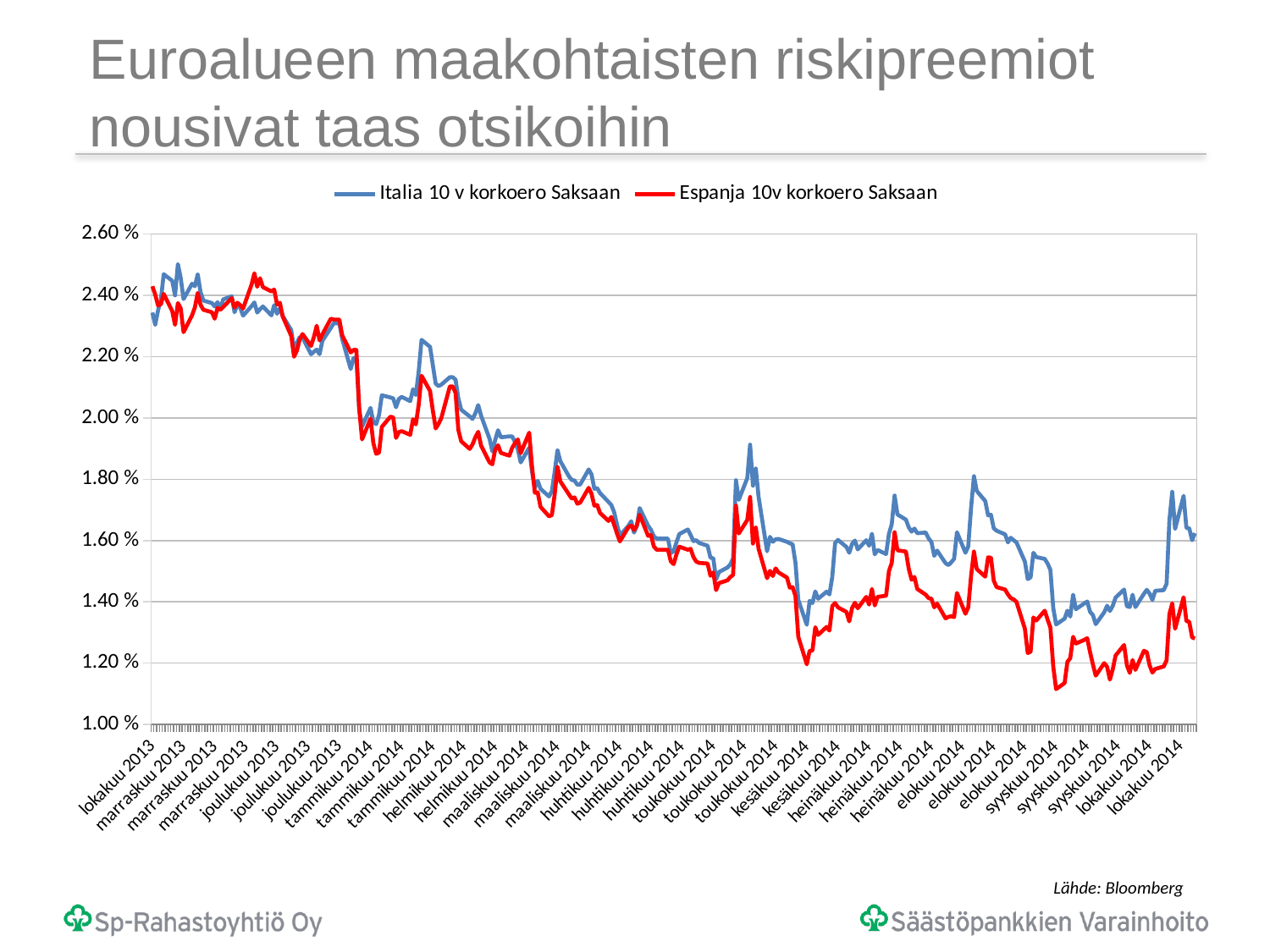
Is the value for Italia 10 v korkoero Saksaan at the end of the chart (lokakuu 2014) greater or less than 1.40 %? greater Is the value for Italia 10 v korkoero Saksaan at the start of the chart (lokakuu 2013) greater or less than 2.20 %? greater Which series reaches the lowest value anywhere on the chart? Espanja 10v korkoero Saksaan What colour is the line for Espanja 10v korkoero Saksaan? Red Is the value for Espanja 10v korkoero Saksaan at the end of the chart (lokakuu 2014) greater or less than 1.40 %? less What kind of chart is shown on the slide? Line chart What are the two series named in the legend? Italia 10 v korkoero Saksaan and Espanja 10v korkoero Saksaan At the end of the chart (lokakuu 2014), which series has the higher value, Italia 10 v korkoero Saksaan or Espanja 10v korkoero Saksaan? Italia 10 v korkoero Saksaan How many series does the legend list? 2 Overall, do the values for Espanja 10v korkoero Saksaan rise or fall from lokakuu 2013 to lokakuu 2014? Fall Overall, do the values for Italia 10 v korkoero Saksaan rise or fall from lokakuu 2013 to lokakuu 2014? Fall